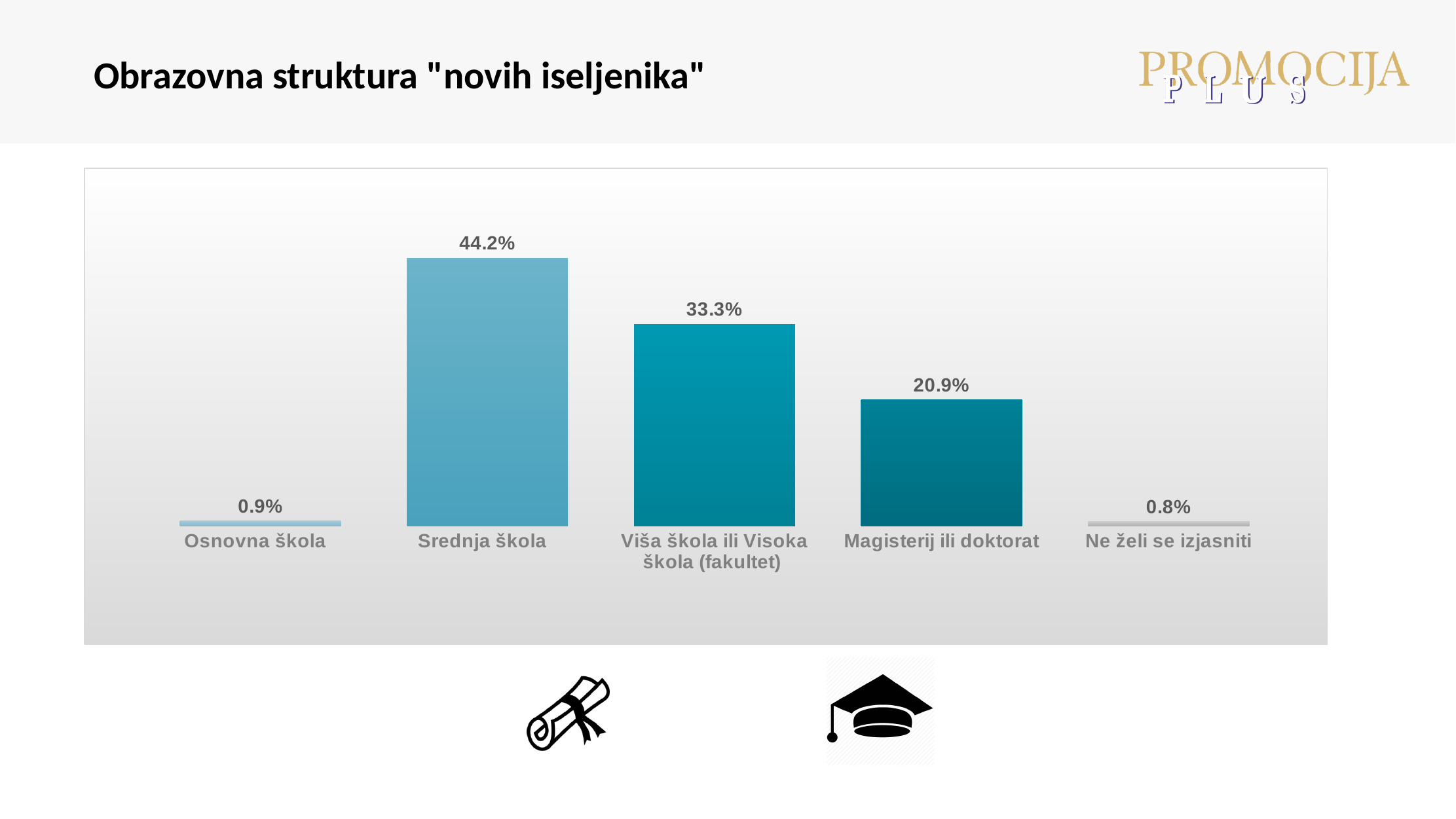
What is the value for Viša škola ili Visoka škola (fakultet)? 33.3% What is the difference between the values for Srednja škola and Viša škola ili Visoka škola (fakultet)? 10.9% What is the value for Srednja škola? 44.2% What is the value for Ne želi se izjasniti? 0.8% What kind of chart is shown on the slide? Bar chart Which is larger, the value for Magisterij ili doktorat or the value for Viša škola ili Visoka škola (fakultet)? Viša škola ili Visoka škola (fakultet) How many categories are shown in the chart? 5 What is the title of the slide? Obrazovna struktura "novih iseljenika" What is the value for Magisterij ili doktorat? 20.9% What is the value for Osnovna škola? 0.9% What is the difference between the values for Viša škola ili Visoka škola (fakultet) and Magisterij ili doktorat? 12.4% Which category has the highest value? Srednja škola